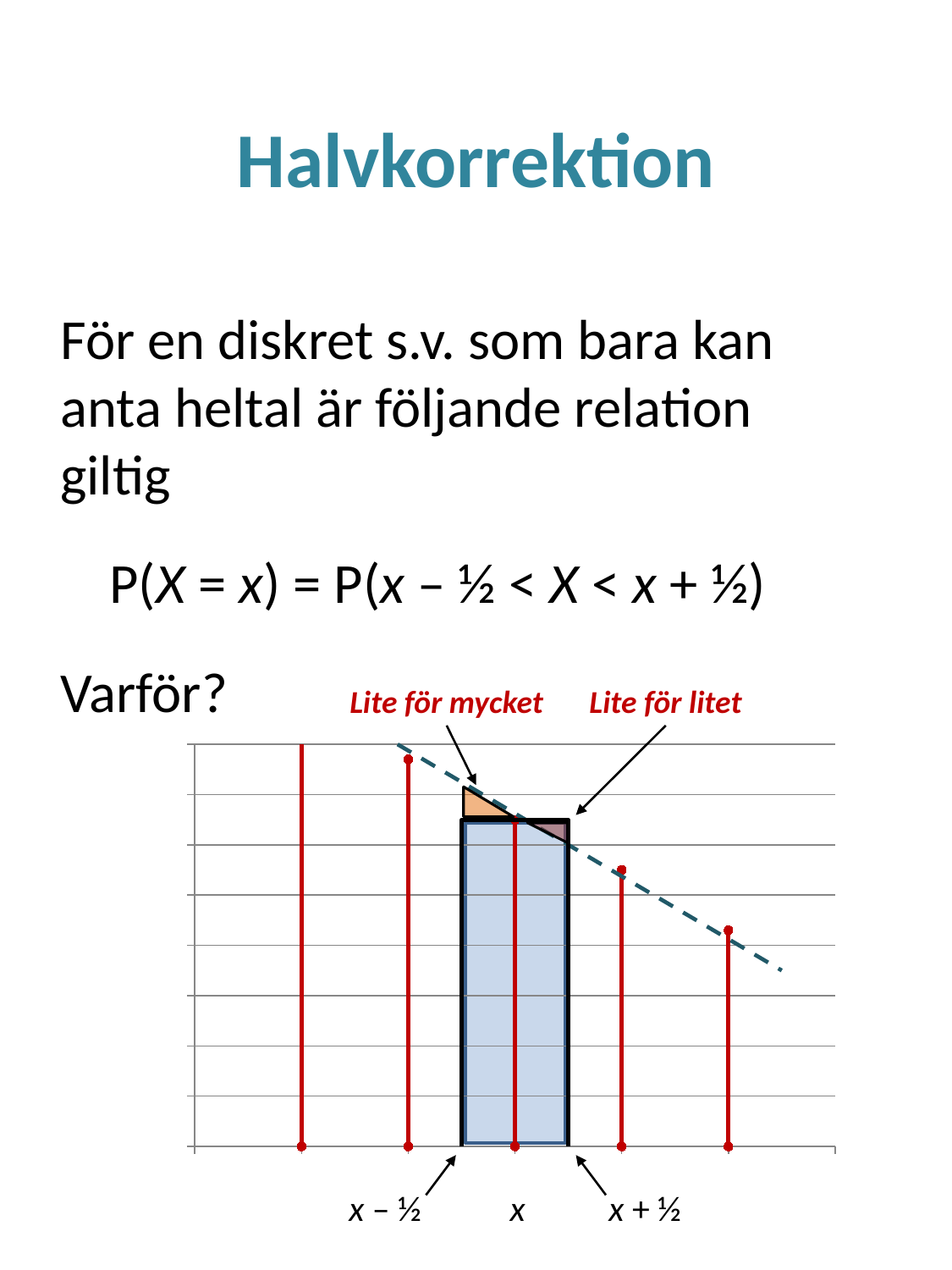
Which red stem is the shortest in the chart? the rightmost one What text labels the small orange triangle above the shaded rectangle? Lite för mycket How many red vertical stems (data points) are plotted in the chart? 5 Which is taller: the red stem at x or the red stem immediately to its right? the red stem at x Do the heights of the red stems rise or fall from left to right along the x axis? fall What are the three labels printed below the x axis of the chart? x − ½, x, x + ½ Which x-axis label marks the right edge of the shaded rectangle? x + ½ What text labels the small grey triangle at the top right of the shaded rectangle? Lite för litet Which x-axis label marks the left edge of the shaded rectangle? x − ½ Which red stem is the tallest: the leftmost one or the rightmost one? the leftmost one